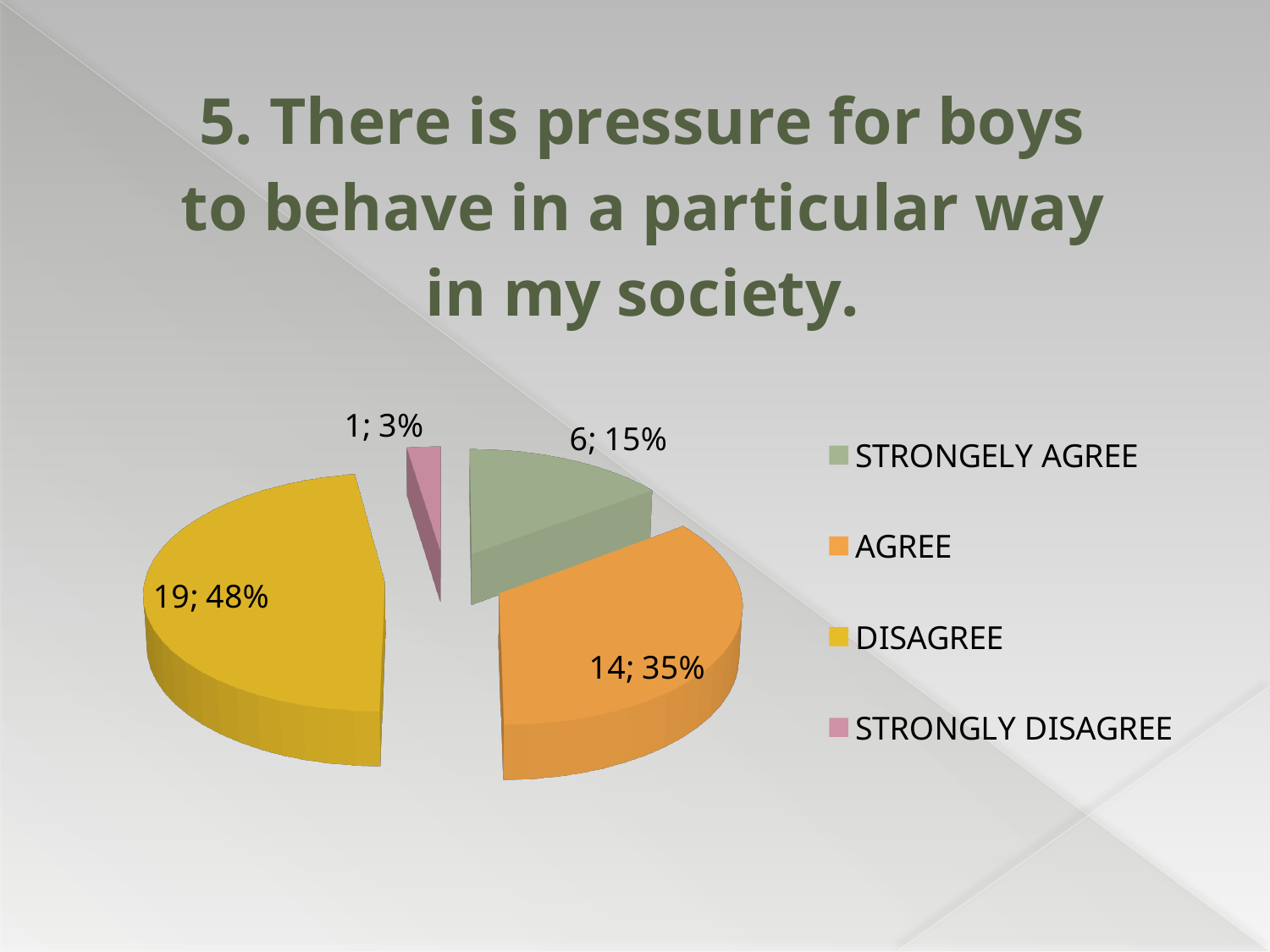
Which is larger, the count for STRONGLY AGREE or the count for AGREE? AGREE What kind of chart is shown on the slide? Pie chart How many slices does the pie chart have? 4 What percentage share does STRONGLY DISAGREE have? 3% What colour is the DISAGREE slice? Yellow What percentage share does AGREE have? 35% Which category has the smallest slice? STRONGLY DISAGREE What is the difference in count between DISAGREE and AGREE? 5 What is the count for STRONGLY AGREE? 6 How many entries does the legend list? 4 Which category has the largest slice? DISAGREE What is the count for DISAGREE? 19